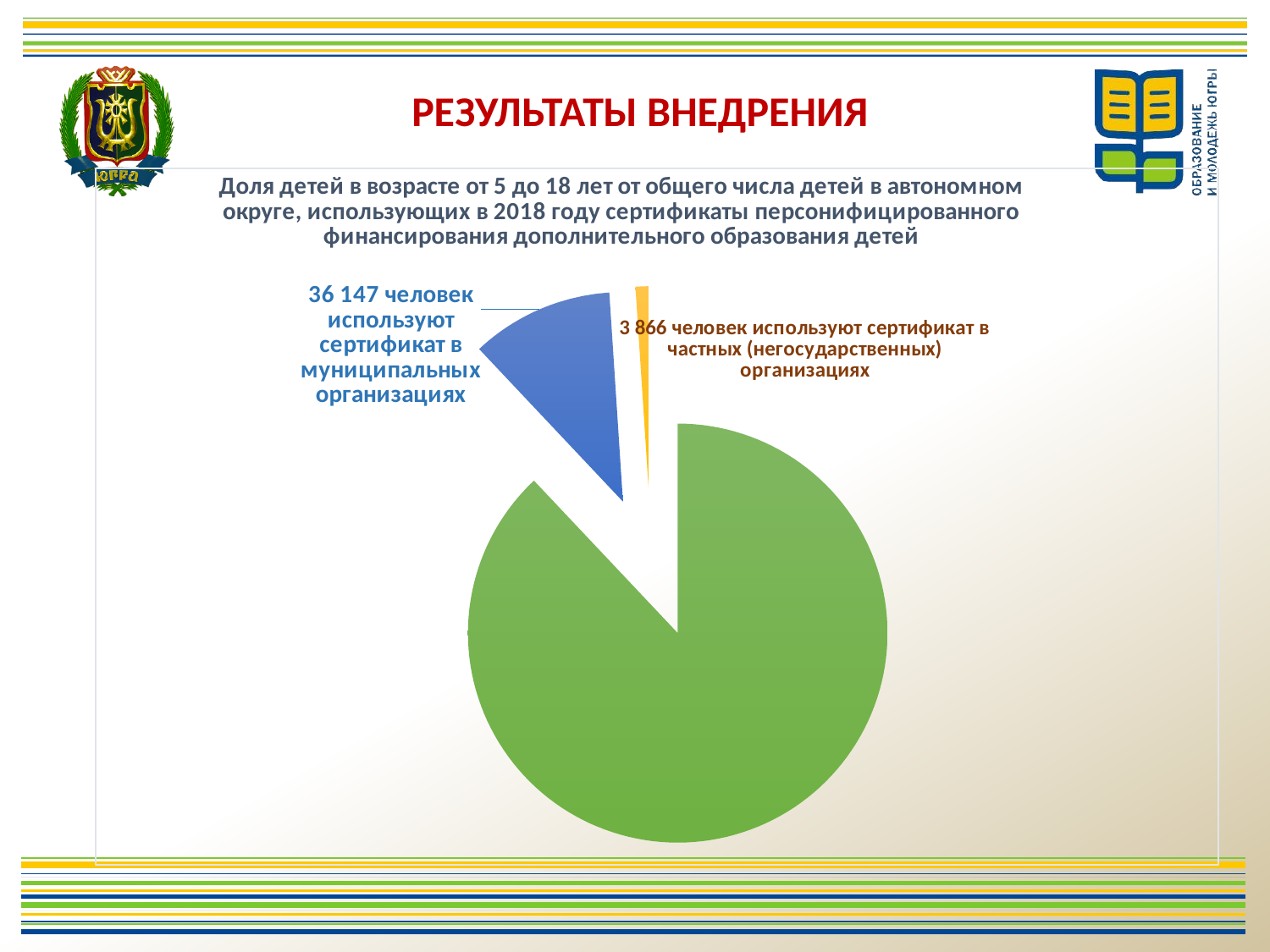
How many children use the certificate in municipal organizations (муниципальных организациях) according to the chart? 36 147 человек What is the difference between the number of children using certificates in municipal organizations and in private (non-state) organizations? 32 281 What kind of chart is shown on the slide? Pie chart Which labelled slice of the pie chart is the smallest? 3 866 человек используют сертификат в частных (негосударственных) организациях How many slices does the pie chart have? 3 What colour is the slice representing children using certificates in municipal organizations? Blue Which slice of the pie chart is the largest? The green (unlabelled) slice Which is larger: the number of children using certificates in municipal organizations or in private (non-state) organizations? Municipal organizations (36 147) How many children use the certificate in private (non-state) organizations (частных (негосударственных) организациях) according to the chart? 3 866 человек What colour is the slice representing children using certificates in private (non-state) organizations? Yellow